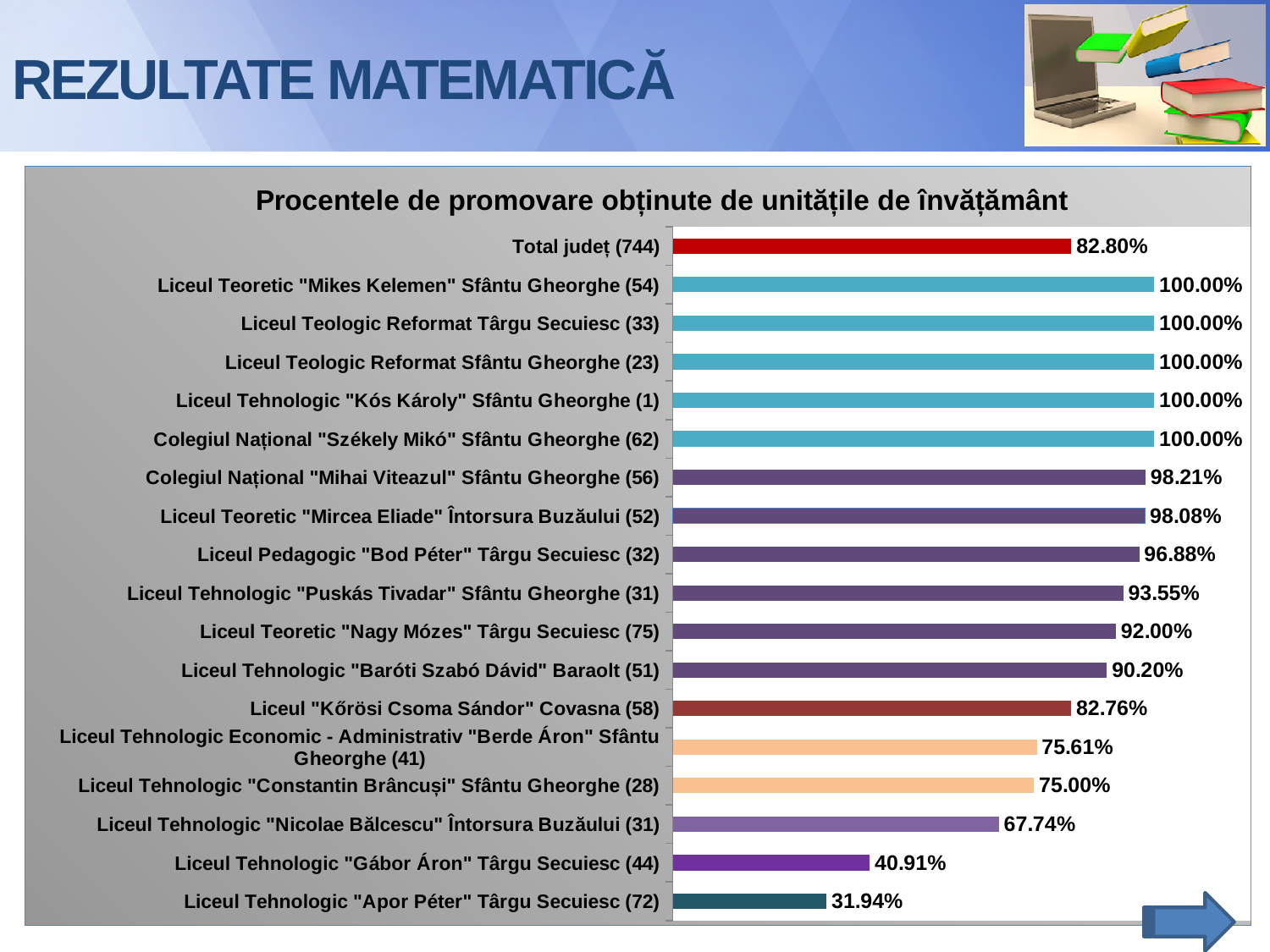
What is the difference between the pass rate for Total județ (744) and Liceul "Kőrösi Csoma Sándor" Covasna (58)? 0.04% What is the difference between the pass rates of Liceul Tehnologic "Gábor Áron" Târgu Secuiesc (44) and Liceul Tehnologic "Apor Péter" Târgu Secuiesc (72)? 8.97% What pass rate is shown for Liceul Tehnologic "Apor Péter" Târgu Secuiesc (72)? 31.94% How many schools on the chart have a pass rate of 100.00%? 5 What pass rate is shown for Liceul Tehnologic "Nicolae Bălcescu" Întorsura Buzăului (31)? 67.74% How many bars (categories) are plotted on the chart, including Total județ? 18 What is the pass rate shown for Total județ (744)? 82.80% What is the title of the chart? Procentele de promovare obținute de unitățile de învățământ Which school has the lowest pass rate on the chart? Liceul Tehnologic "Apor Péter" Târgu Secuiesc (72) Which has a higher pass rate: Liceul Tehnologic Economic - Administrativ "Berde Áron" Sfântu Gheorghe (41) or Liceul Tehnologic "Constantin Brâncuși" Sfântu Gheorghe (28)? Liceul Tehnologic Economic - Administrativ "Berde Áron" Sfântu Gheorghe (41) What type of chart is shown on the slide? Bar chart What pass rate is shown for Colegiul Național "Mihai Viteazul" Sfântu Gheorghe (56)? 98.21%